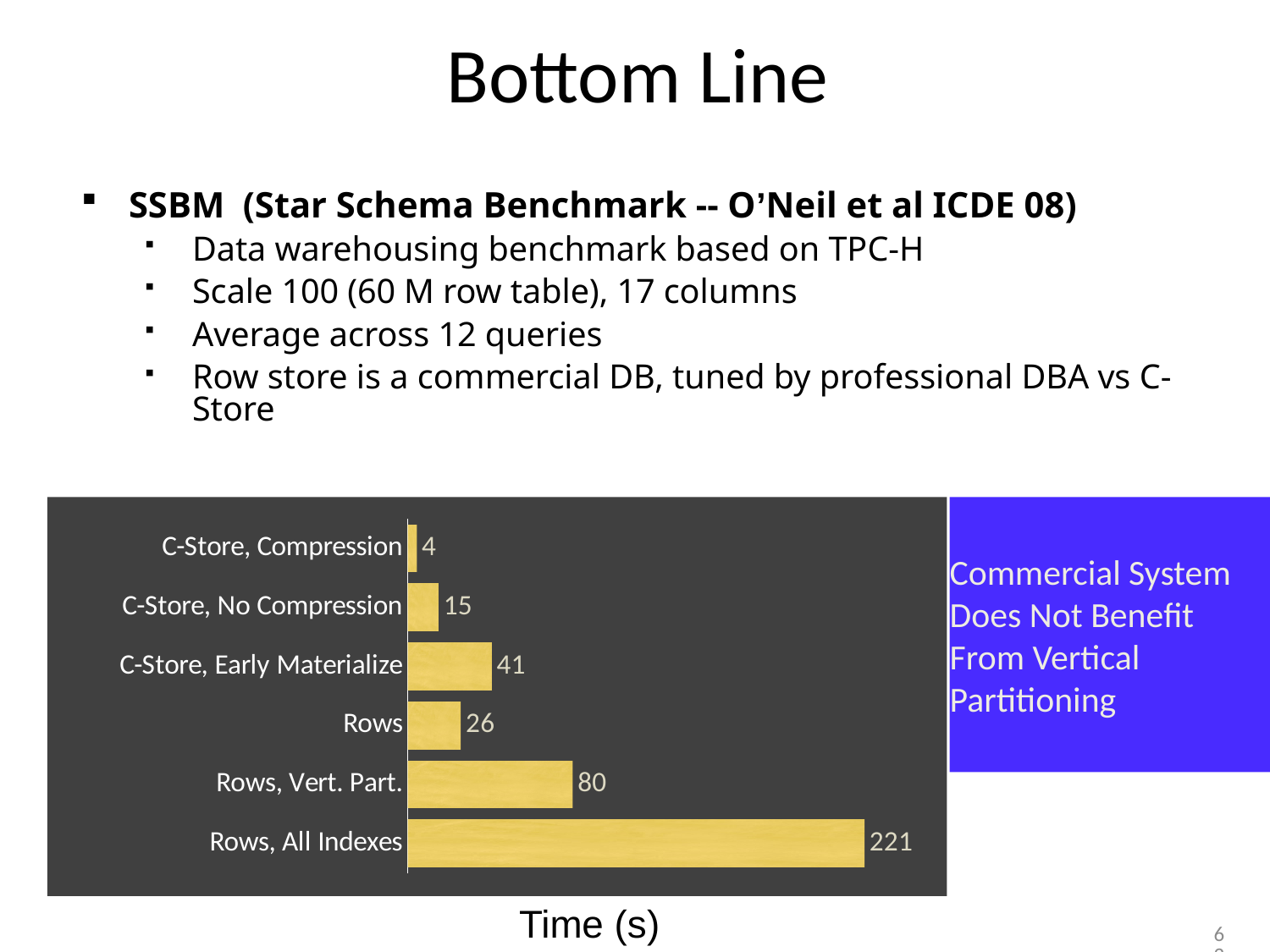
What is the difference in time between C-Store, No Compression and C-Store, Compression? 11 What is the time in seconds for Rows, All Indexes? 221 What is the difference in time between Rows, Vert. Part. and Rows? 54 What is the time in seconds for Rows, Vert. Part.? 80 How many configurations are shown in the chart? 6 Which configuration has the highest time? Rows, All Indexes What is the time in seconds for C-Store, Compression? 4 What kind of chart is shown on the slide? Bar chart What is the time in seconds for C-Store, Early Materialize? 41 Which has a larger time, Rows or C-Store, No Compression? Rows Which configuration has the lowest time? C-Store, Compression What is the label of the chart's value axis? Time (s)